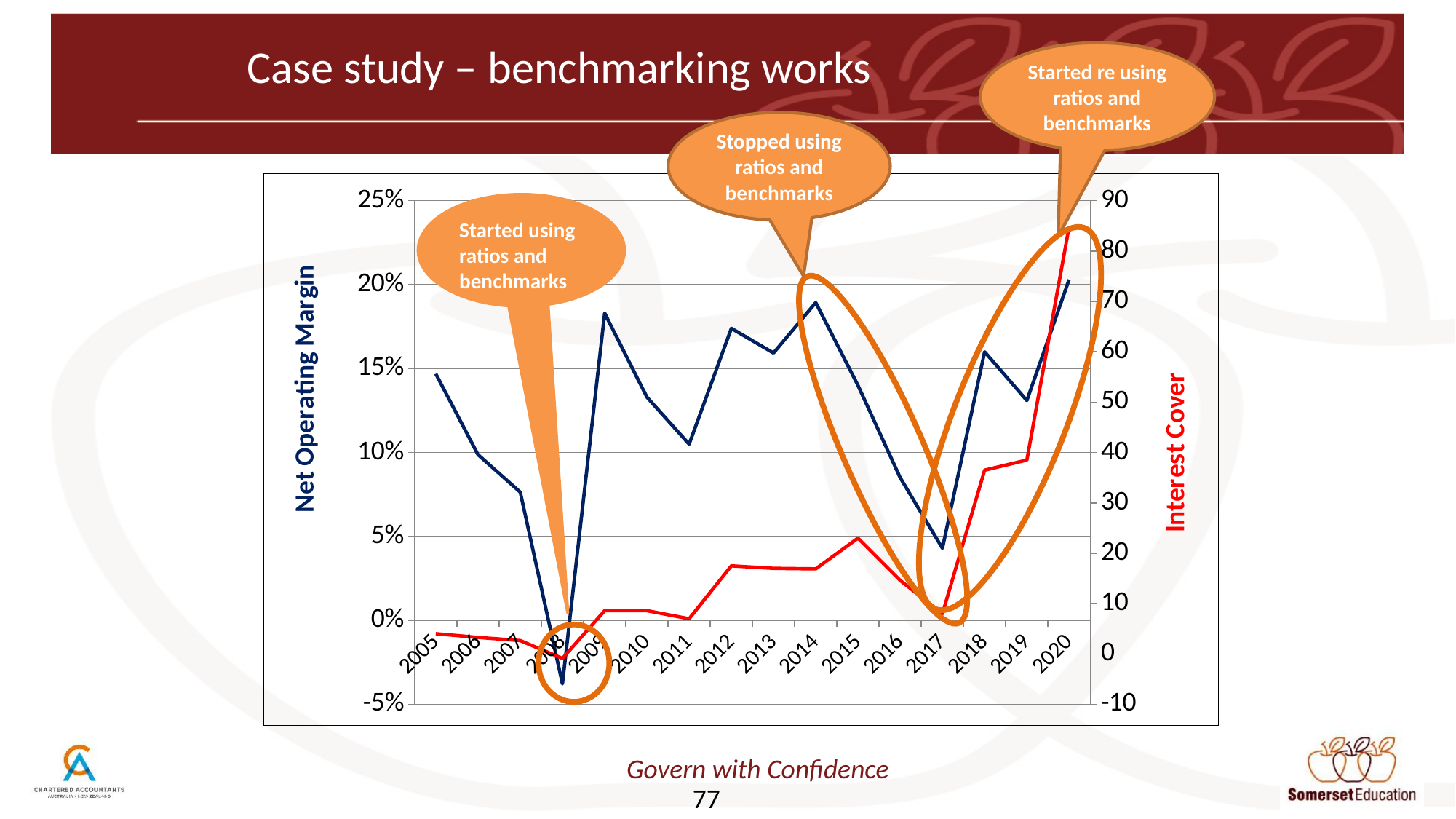
Which year has the higher Interest Cover, 2015 or 2017? 2015 Does Interest Cover rise or fall from 2017 to 2020? Rise How many years are plotted along the x axis of the chart? 16 Which year has the higher Net Operating Margin, 2005 or 2006? 2005 In which year is Interest Cover at its lowest? 2008 Is the Net Operating Margin for 2016 greater or less than 10%? less In which year is Net Operating Margin at its lowest? 2008 Is the Interest Cover for 2020 greater or less than 70? greater In which year is Interest Cover at its highest? 2020 Is the Net Operating Margin for 2009 greater or less than 15%? greater What does the callout pointing at 2008 say? Started using ratios and benchmarks What kind of chart is shown on the slide? Line chart